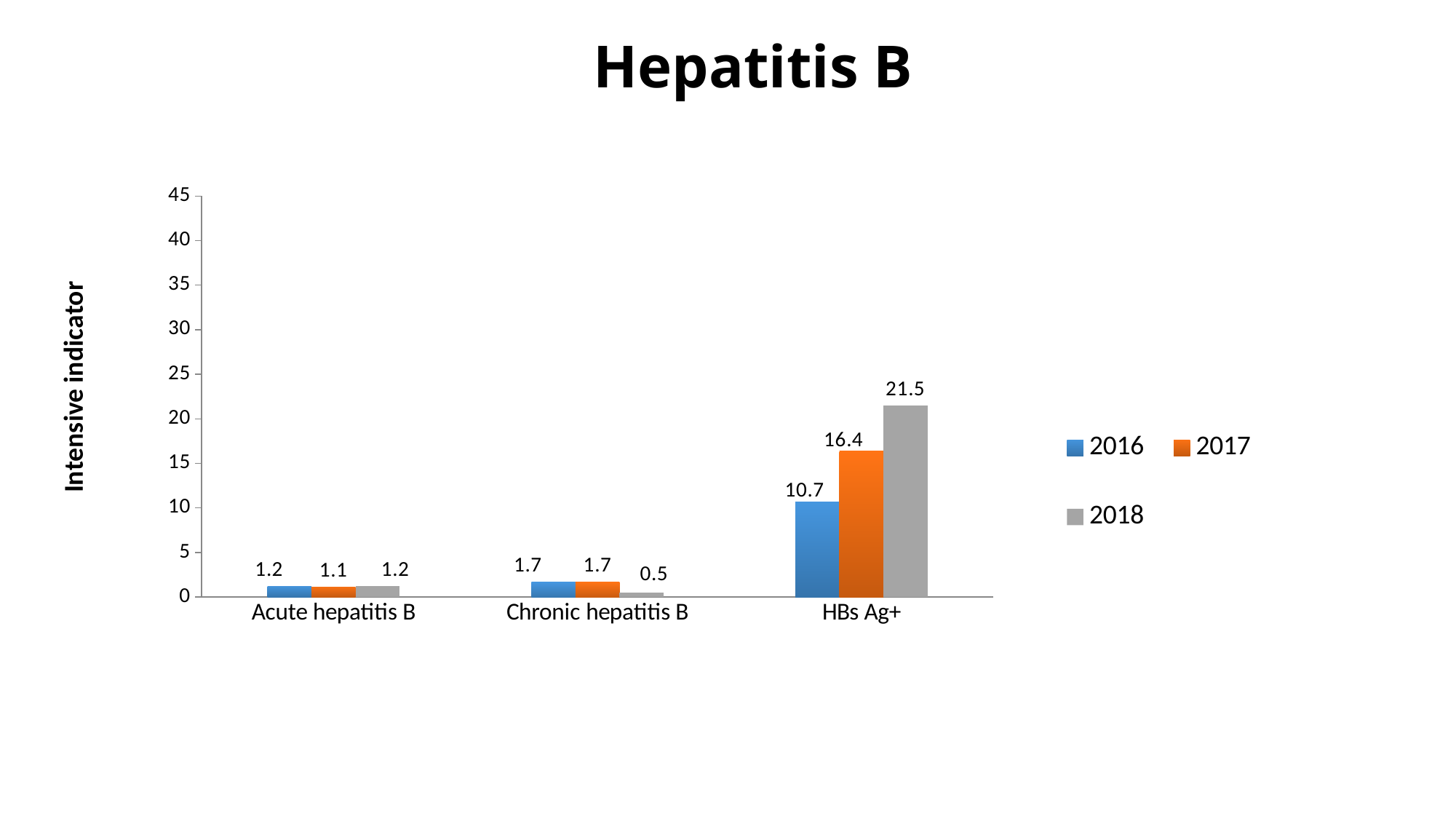
What is the value for HBs Ag+ in 2018? 21.5 Which category has the highest value in 2017? HBs Ag+ What is the label of the vertical axis? Intensive indicator What is the value for Acute hepatitis B in 2016? 1.2 Is the value for HBs Ag+ in 2017 greater or less than 15? greater How many categories are shown on the x axis? 3 How many series does the legend list? 3 What is the value for Chronic hepatitis B in 2017? 1.7 Which is larger for Chronic hepatitis B: the 2017 value or the 2018 value? 2017 Which category has the lowest value in 2018? Chronic hepatitis B What is the difference between the 2018 and 2016 values for HBs Ag+? 10.8 What kind of chart is shown on the slide? bar chart